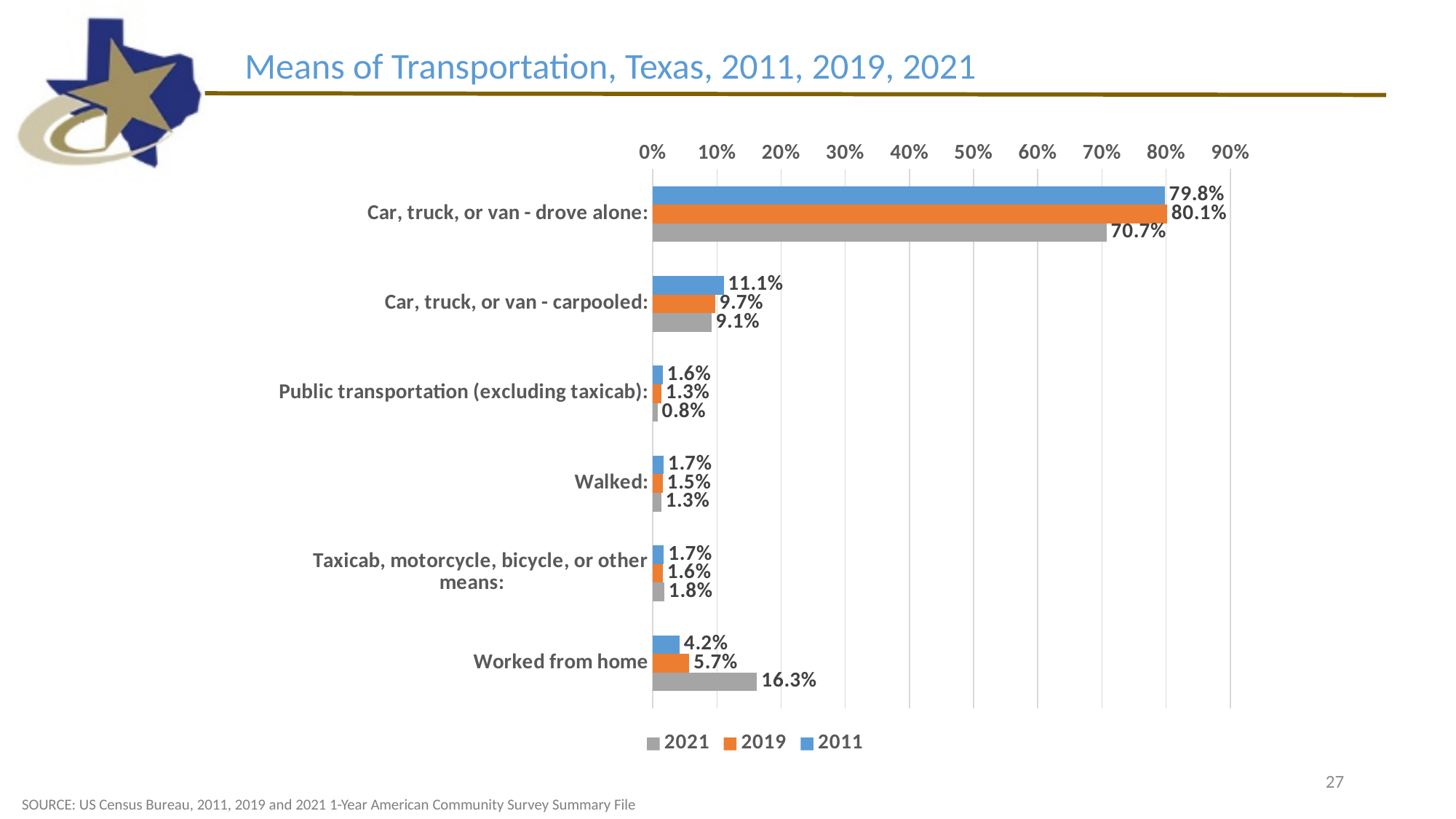
What is the 2021 value for "Public transportation (excluding taxicab)"? 0.8% How many categories are shown on the chart? 6 What kind of chart is shown on the slide? bar chart Which is larger for "Car, truck, or van - drove alone": the 2019 value or the 2021 value? 2019 Which category has the lowest 2011 value? Public transportation (excluding taxicab) What is the 2019 value for "Car, truck, or van - carpooled"? 9.7% Is the 2021 value for "Car, truck, or van - drove alone" greater or less than 80%? less What is the 2011 value for "Car, truck, or van - drove alone"? 79.8% What is the difference between the 2021 and 2011 values for "Worked from home"? 12.1% What is the 2021 value for "Worked from home"? 16.3% How many series does the legend list? 3 Which category has the highest 2021 value? Car, truck, or van - drove alone